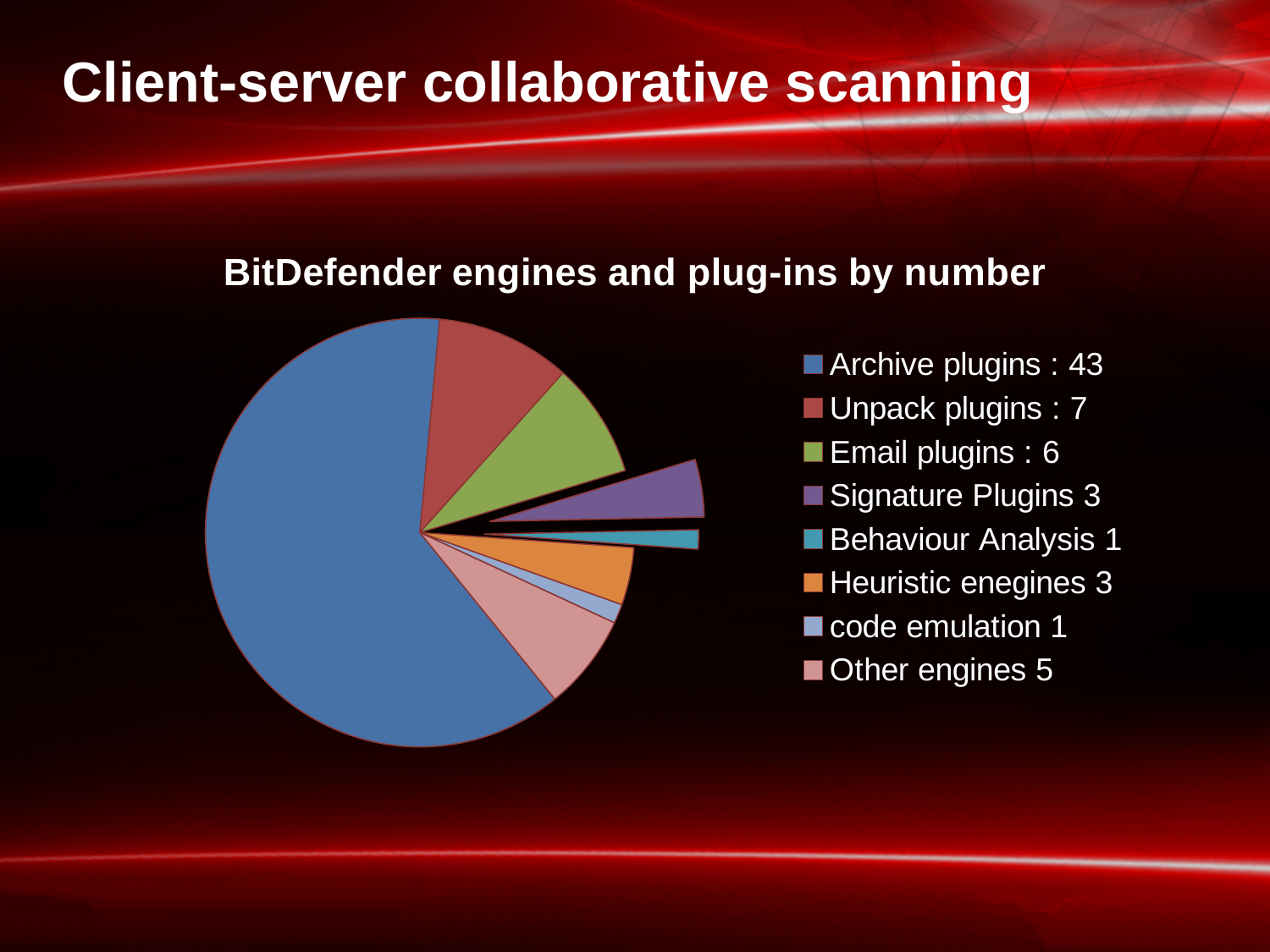
What is the number of Email plugins? 6 What is the title of the chart? BitDefender engines and plug-ins by number Which is larger, Email plugins or Signature Plugins? Email plugins What is the difference between the number of Archive plugins and Unpack plugins? 36 What kind of chart is shown on the slide? pie chart Which category has the largest slice of the pie? Archive plugins How many categories does the pie chart have? 8 What is the total of all the values shown in the legend? 69 What is the number of Unpack plugins? 7 What is the number of Other engines? 5 What colour is the slice for Archive plugins? blue What is the number of Archive plugins? 43